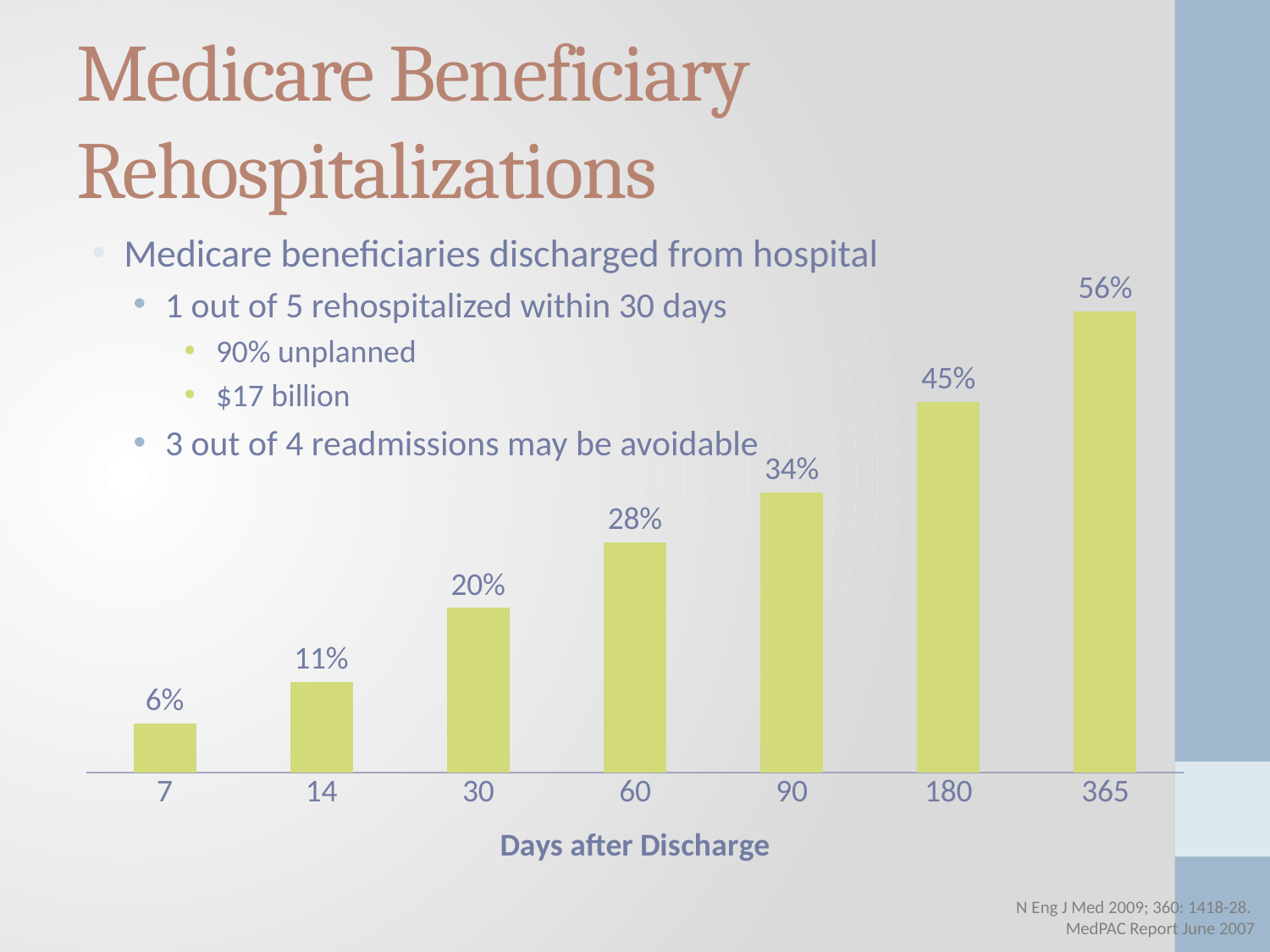
Which number of days after discharge has the highest value? 365 What is the difference between the values at 365 days and 180 days? 11% What is the value shown for 7 days after discharge? 6% Which number of days after discharge has the lowest value? 7 Which is larger, the value at 60 days or the value at 90 days? 90 days What is the rehospitalization value at 30 days after discharge? 20% How many bars are shown in the chart? 7 What is the label of the x axis? Days after Discharge What kind of chart is shown on the slide? Bar chart What is the difference between the values at 60 days and 14 days? 17% What is the value shown for 90 days after discharge? 34% Do the values rise or fall as the days after discharge increase? Rise